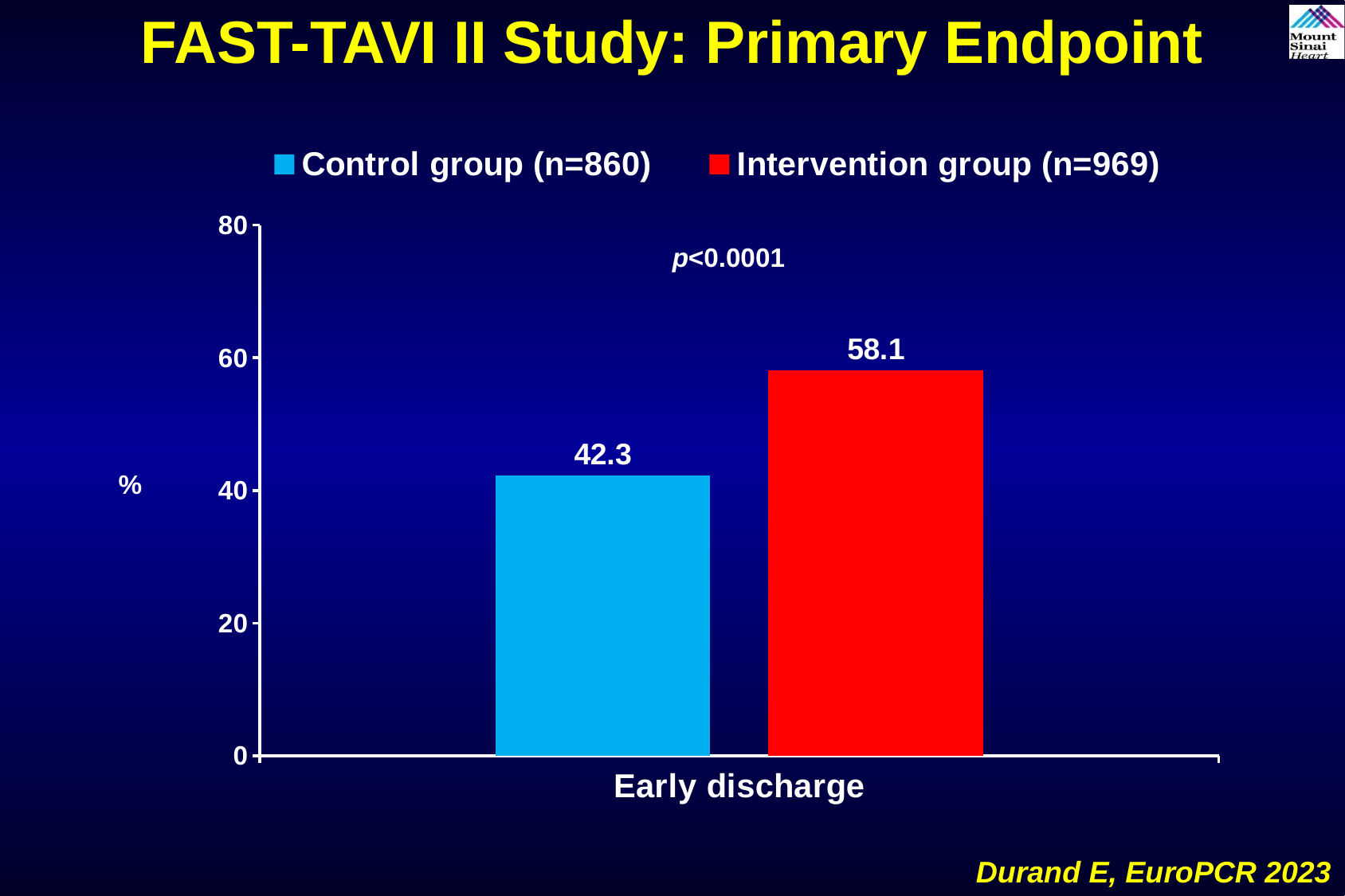
What is the difference between the Intervention group and Control group early discharge values? 15.8 What is the early discharge value for the Control group (n=860)? 42.3 Is the early discharge value for the Intervention group greater or less than 60? less Which group has the higher early discharge rate? Intervention group (n=969) Which group has the lower early discharge rate? Control group (n=860) Is the early discharge value for the Control group greater or less than 40? greater What p-value is shown on the chart? p<0.0001 What kind of chart is shown on the slide? Bar chart What is the unit shown on the y axis? % What is the category label on the x axis? Early discharge How many series does the legend list? 2 What is the early discharge value for the Intervention group (n=969)? 58.1